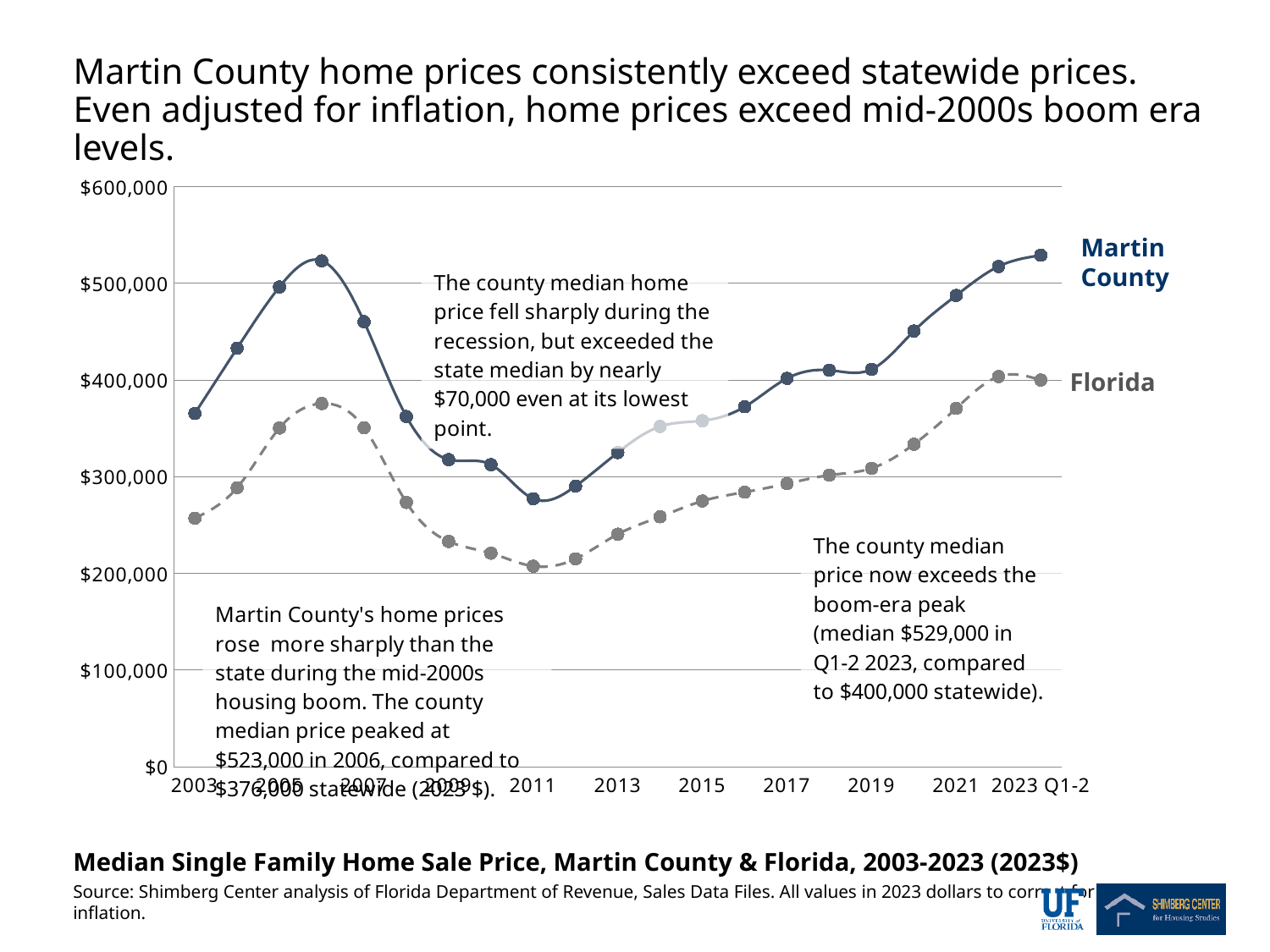
Which series has the higher value in 2011, Martin County or Florida? Martin County Is the Martin County value for 2011 greater or less than $300,000? less What was the Martin County median home price at its 2006 peak? $523,000 Does the Martin County line rise or fall between 2006 and 2011? fall How many series does the chart plot? 2 By how much did the Martin County median exceed the Florida median in 2006? $147,000 What is the Martin County median home price in Q1-2 2023? $529,000 What is the Florida statewide median home price in Q1-2 2023? $400,000 What was the Florida statewide median home price in 2006? $376,000 By how much does the Martin County median exceed the Florida median in Q1-2 2023? $129,000 What is the title of the chart? Median Single Family Home Sale Price, Martin County & Florida, 2003-2023 (2023$) What kind of chart is shown on the slide? line chart